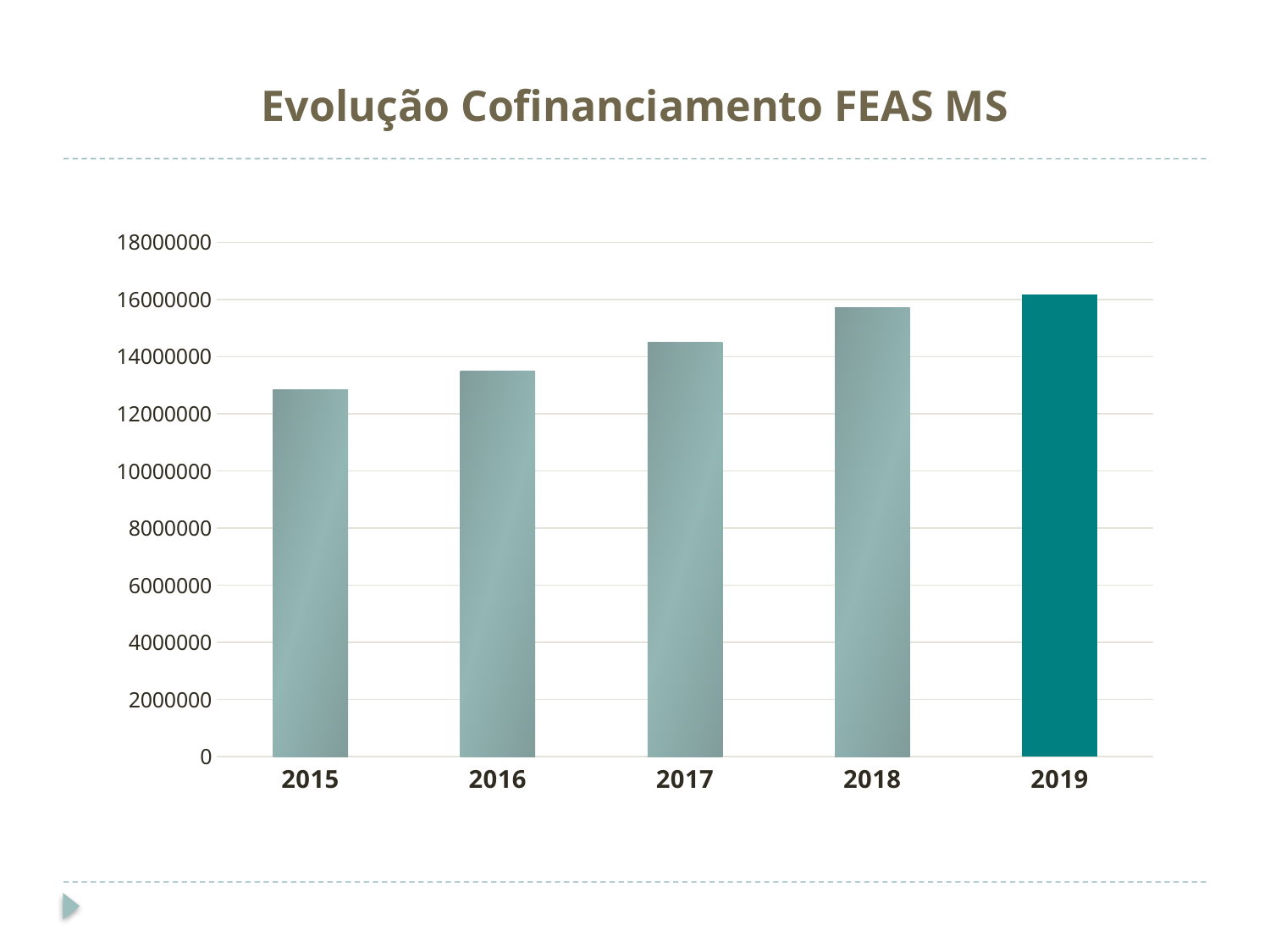
Which year has the lowest value in the chart? 2015 Is the value for 2016 greater or less than 14000000? less What kind of chart is shown on the slide? bar chart Which year has the highest value in the chart? 2019 How many years are shown on the x axis of the chart? 5 Is the value for 2015 greater or less than 12000000? greater Which is larger, the value for 2015 or the value for 2017? 2017 Which bar is shown in a different, darker colour from the others? 2019 What is the title of the chart? Evolução Cofinanciamento FEAS MS Is the value for 2017 greater or less than 14000000? greater Do the values rise or fall from 2015 to 2019? rise